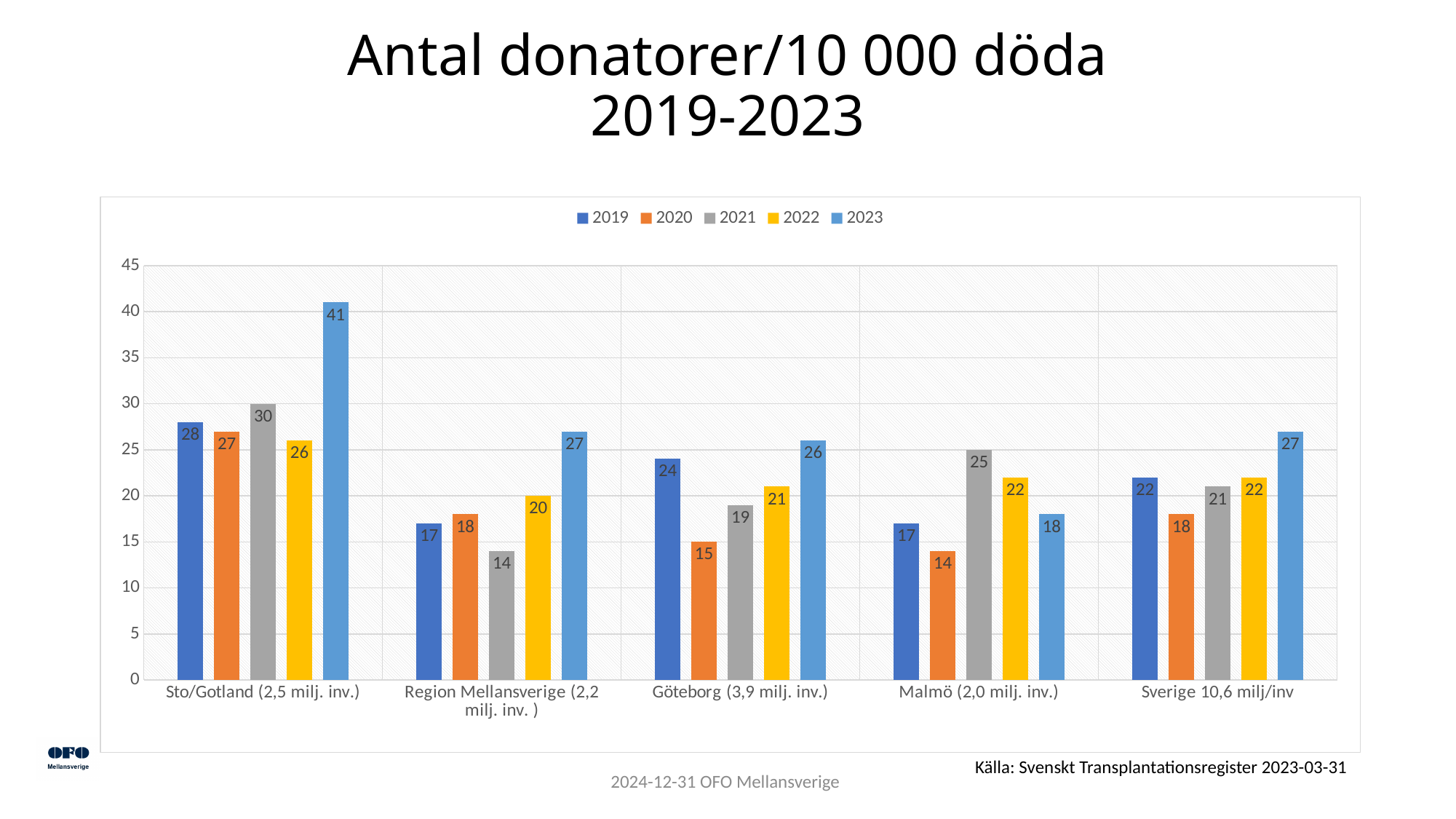
What is the value for Malmö (2,0 milj. inv.) in 2021? 25 What is the difference between the 2023 and 2019 values for Sto/Gotland (2,5 milj. inv.)? 13 How many series does the legend list? 5 Which category has the lowest value in 2019? Region Mellansverige (2,2 milj. inv.) and Malmö (2,0 milj. inv.) Which is larger for Malmö (2,0 milj. inv.): the 2021 value or the 2023 value? 2021 What is the value for Sto/Gotland (2,5 milj. inv.) in 2023? 41 Which category has the highest value in 2023? Sto/Gotland (2,5 milj. inv.) What is the value for Göteborg (3,9 milj. inv.) in 2020? 15 What kind of chart is shown on the slide? Bar chart What is the title of the chart on the slide? Antal donatorer/10 000 döda 2019-2023 How many categories are shown on the x axis? 5 What is the value for Region Mellansverige (2,2 milj. inv.) in 2021? 14